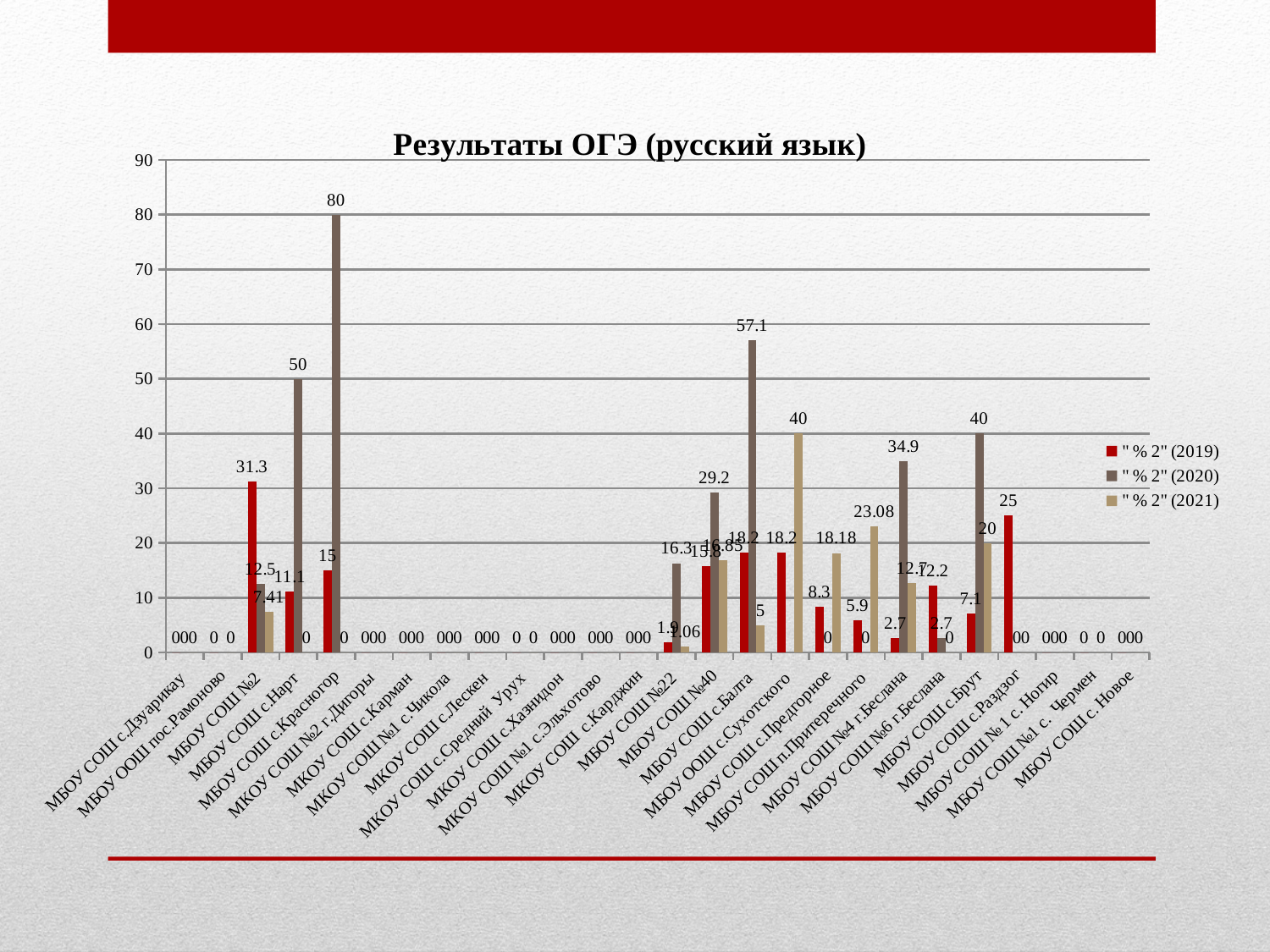
Which category has the highest " % 2" (2019) value? МБОУ СОШ №2 What is the " % 2" (2020) value for МБОУ СОШ с.Красногор? 80 Which category has the highest " % 2" (2020) value? МБОУ СОШ с.Красногор What is the " % 2" (2020) value for МБОУ СОШ №4 г.Беслана? 34.9 How many series does the legend list? 3 What is the " % 2" (2019) value for МБОУ СОШ №2? 31.3 What is the " % 2" (2021) value for МБОУ СОШ п.Притеречного? 23.08 What is the difference between the " % 2" (2020) and " % 2" (2019) values for МБОУ СОШ с.Балта? 38.9 Which has the larger " % 2" (2020) value, МБОУ СОШ с.Нарт or МБОУ СОШ с.Брут? МБОУ СОШ с.Нарт What is the title of the chart? Результаты ОГЭ (русский язык) What is the " % 2" (2021) value for МБОУ ООШ с.Сухотского? 40 What kind of chart is shown on the slide? bar chart